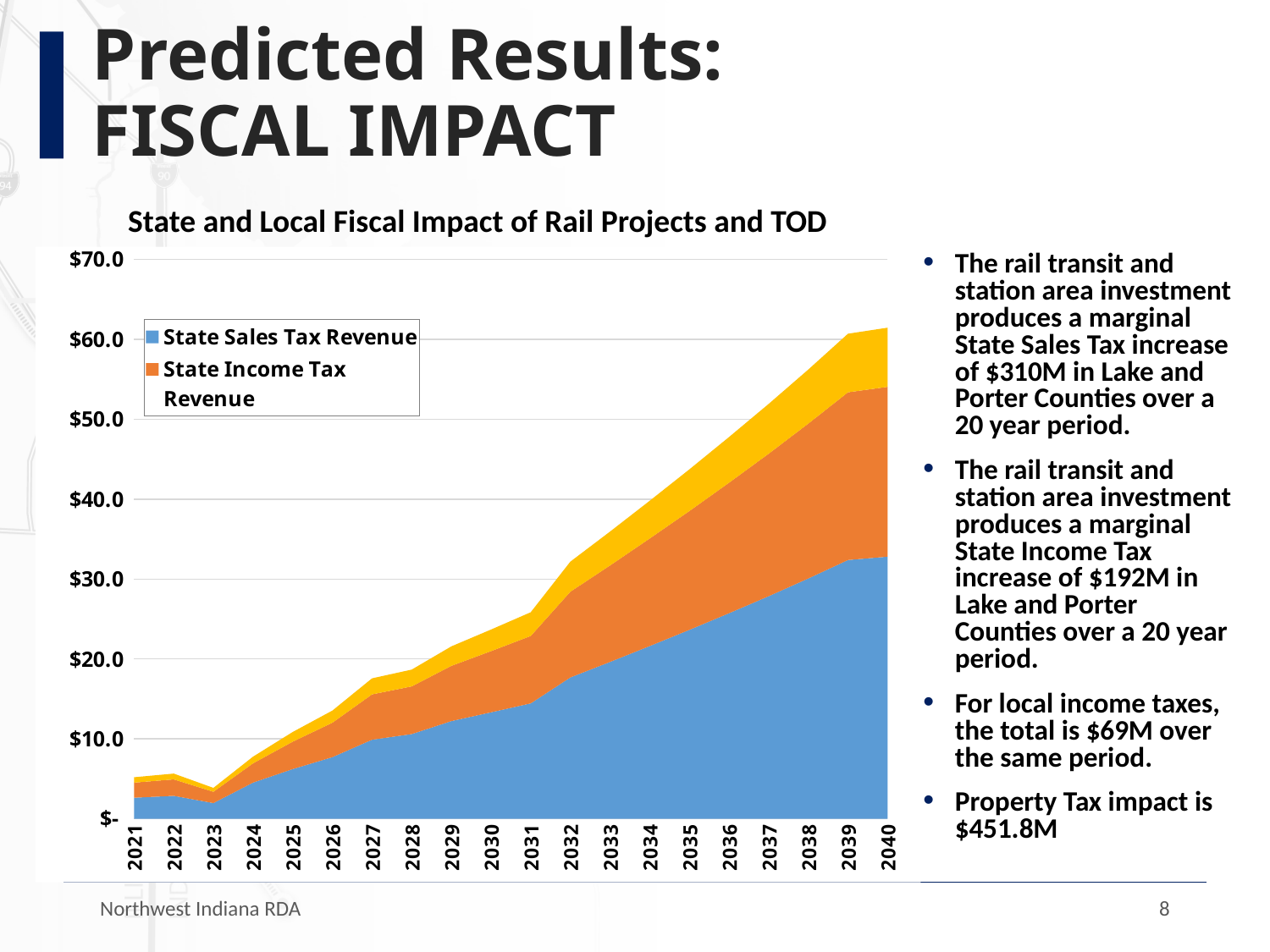
Is the State Sales Tax Revenue value for 2040 greater or less than $30.0? greater How many years are plotted along the x axis of the chart? 20 What kind of chart is shown on the slide? Stacked area chart Is the total stacked value for 2021 greater or less than $10.0? less Is the total stacked value for 2031 greater or less than $30.0? less What is the title of the chart? State and Local Fiscal Impact of Rail Projects and TOD Do the stacked values generally rise or fall from 2021 to 2040? Rise How many series does the chart's legend list? 2 Which series is shown in blue in the chart? State Sales Tax Revenue In which year is the total stacked value highest? 2040